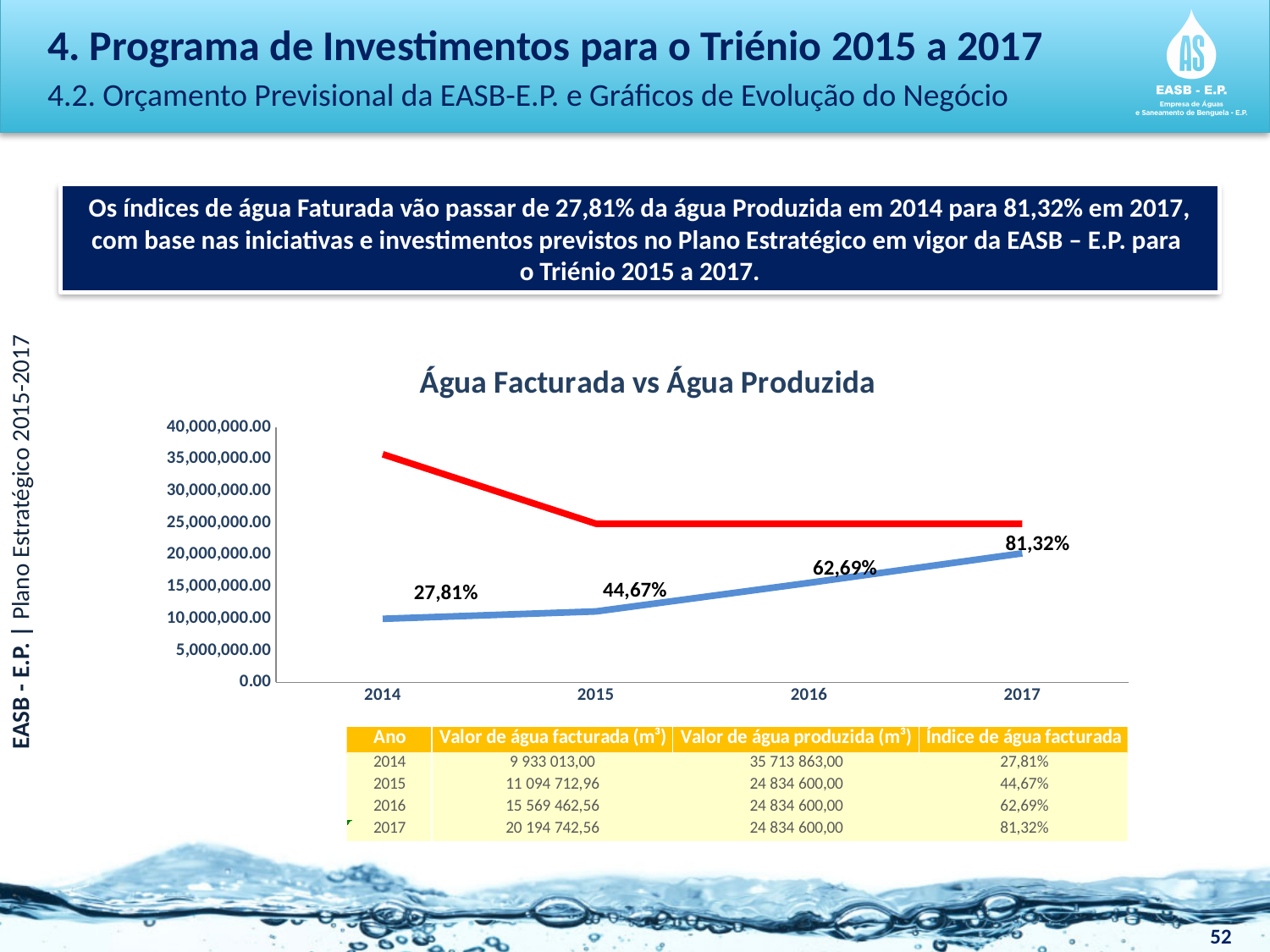
What kind of chart is shown on the slide? line chart In 2017, which line is higher on the chart, the red line or the blue line? the red line What percentage label is shown on the blue line for 2014? 27,81% Does the red line rise or fall from 2014 to 2015? fall How many years are plotted along the x axis of the chart? 4 Which year has the highest percentage label on the blue line? 2017 Is the value of the red line in 2014 greater or less than 30,000,000.00? greater Is the value of the blue line in 2014 greater or less than 15,000,000.00? less Does the blue line rise or fall from 2014 to 2017? rise What percentage label is shown on the blue line for 2016? 62,69% What is the title of the chart? Água Facturada vs Água Produzida What is the difference between the percentage labels for 2017 and 2014 on the blue line? 53,51%